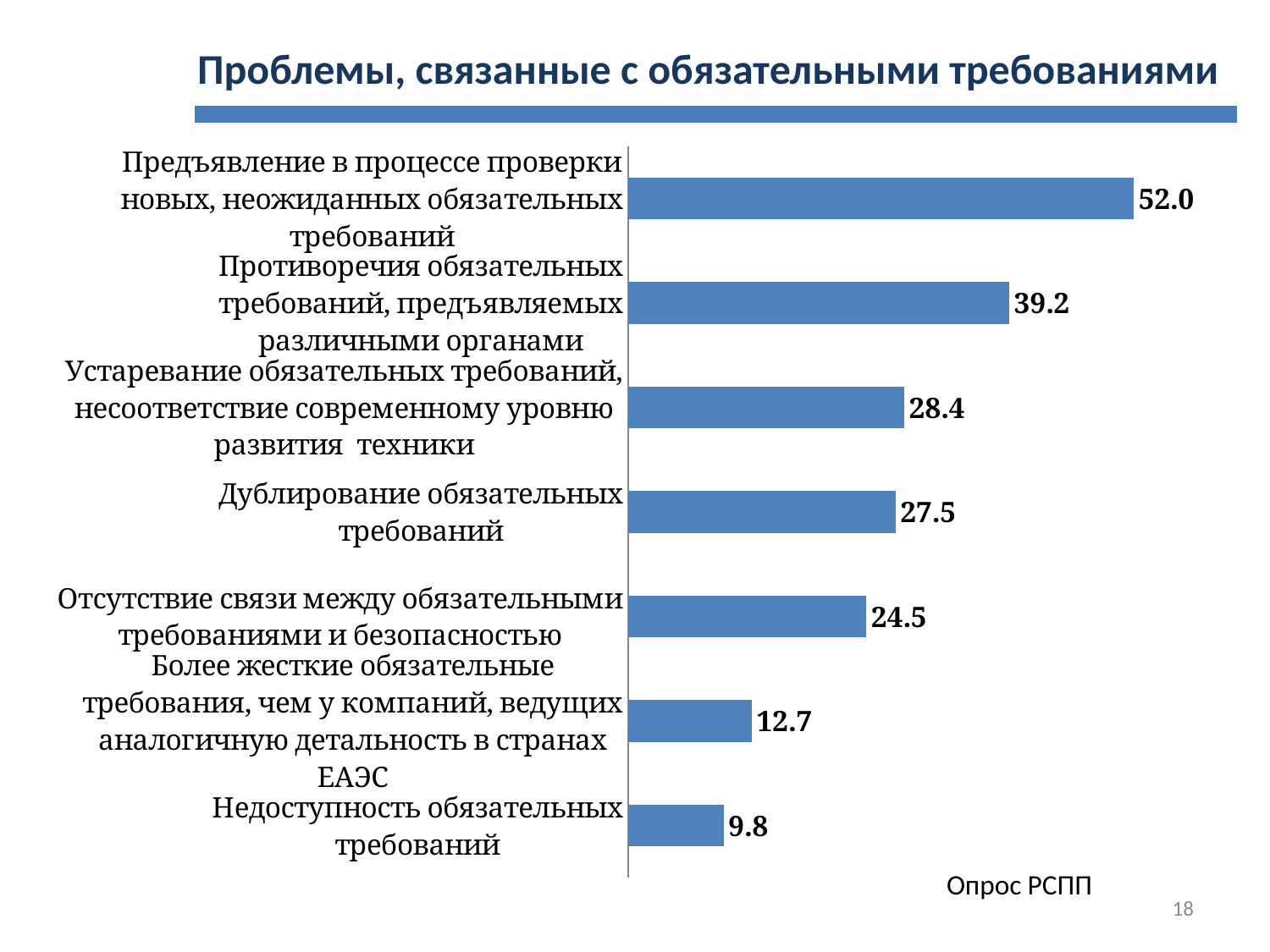
What kind of chart is shown on the slide? Bar chart What is the difference between the values for "Устаревание обязательных требований, несоответствие современному уровню развития техники" and "Дублирование обязательных требований"? 0.9 What is the value for "Дублирование обязательных требований"? 27.5 How many categories are shown in the chart? 7 What is the value for "Отсутствие связи между обязательными требованиями и безопасностью"? 24.5 Which category has the lowest value? Недоступность обязательных требований What is the title of the slide? Проблемы, связанные с обязательными требованиями What is the difference between the values for "Предъявление в процессе проверки новых, неожиданных обязательных требований" and "Противоречия обязательных требований, предъявляемых различными органами"? 12.8 What is the value for "Недоступность обязательных требований"? 9.8 Which category has the highest value? Предъявление в процессе проверки новых, неожиданных обязательных требований Which is larger: the value for "Противоречия обязательных требований, предъявляемых различными органами" or the value for "Устаревание обязательных требований, несоответствие современному уровню развития техники"? Противоречия обязательных требований, предъявляемых различными органами What is the value for "Предъявление в процессе проверки новых, неожиданных обязательных требований"? 52.0